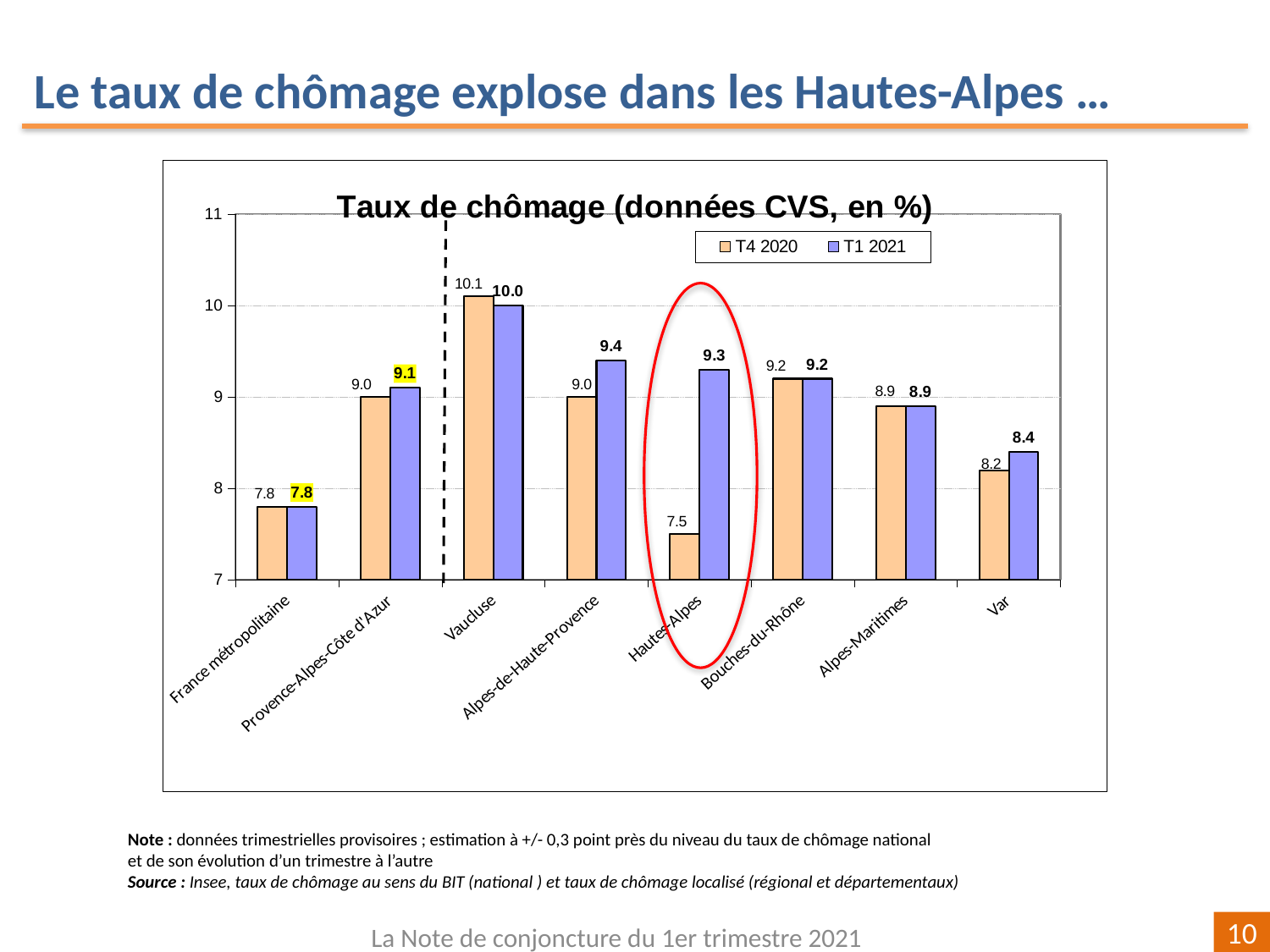
What is the T1 2021 value for Var? 8.4 Which is larger for Vaucluse: the T4 2020 value or the T1 2021 value? T4 2020 What is the T4 2020 unemployment rate for Hautes-Alpes? 7.5 How many categories are shown on the x axis? 8 What is the T1 2021 unemployment rate for Hautes-Alpes? 9.3 What is the title of the chart? Taux de chômage (données CVS, en %) By how much did the unemployment rate in Hautes-Alpes increase from T4 2020 to T1 2021? 1.8 How many series does the legend list? 2 What kind of chart is shown? Bar chart Which category has the lowest T4 2020 value? Hautes-Alpes Which category has the lowest T1 2021 value? France métropolitaine Which category has the highest T4 2020 value? Vaucluse